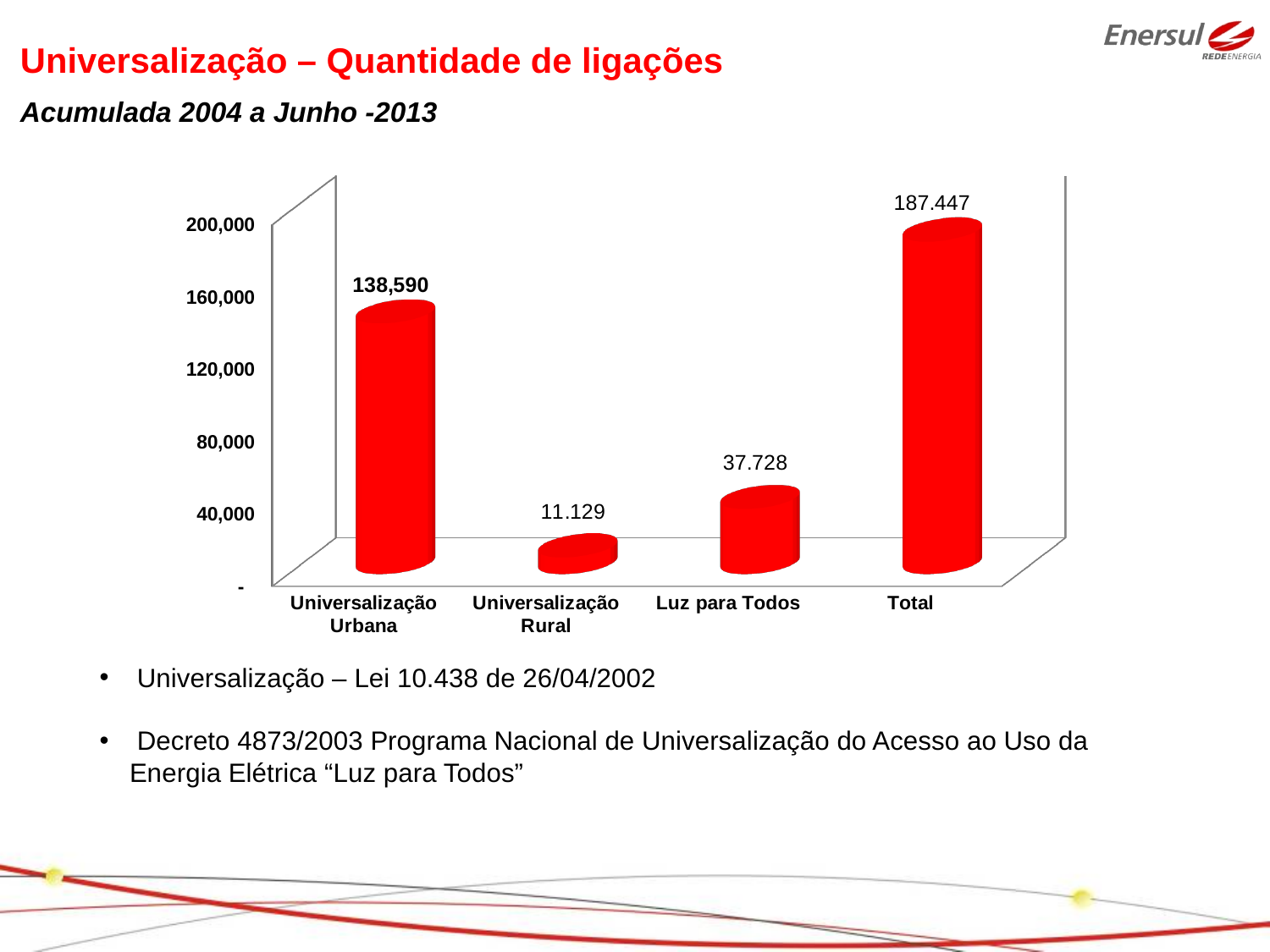
Which is larger, Luz para Todos or Universalização Rural? Luz para Todos Which category has the lowest bar? Universalização Rural What is the difference between the Total and Luz para Todos values? 149.719 What kind of chart is shown on the slide? bar chart What is the difference between Luz para Todos and Universalização Rural? 26.599 Is the value for Universalização Urbana greater or less than 120,000? greater What value is shown for the Total bar? 187.447 What value is shown for Universalização Urbana? 138,590 Which category has the highest bar? Total How many categories are shown on the x axis? 4 What value is shown for Universalização Rural? 11.129 What value is shown for Luz para Todos? 37.728